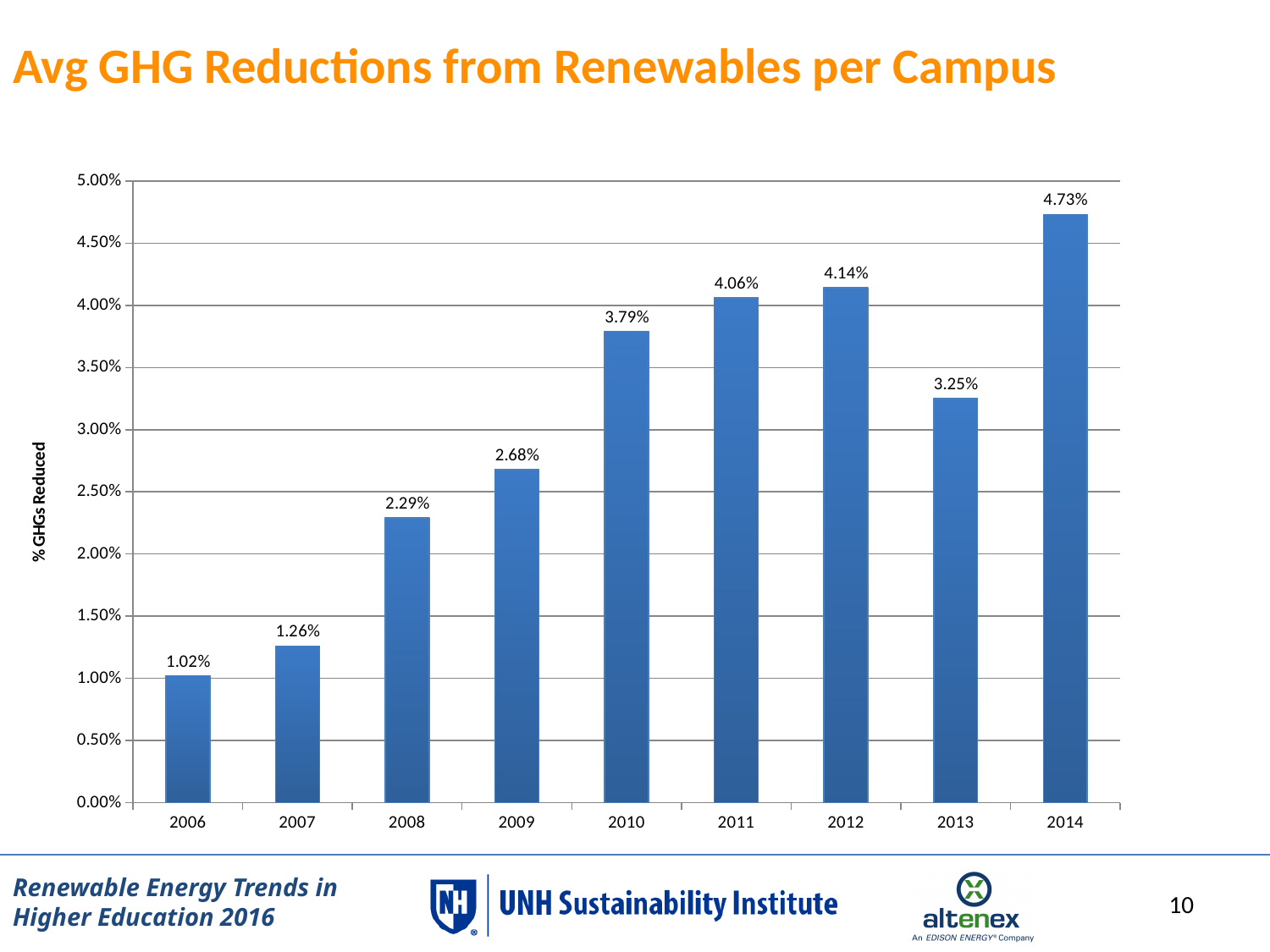
What is the value for 2010? 3.79% Which is larger, the value for 2011 or the value for 2012? 2012 What is the difference between the values for 2014 and 2013? 1.48% Which year has the highest value? 2014 Which year has the lowest value? 2006 What is the value for 2013? 3.25% What is the label of the y axis? % GHGs Reduced Is the value for 2009 greater or less than 3.00%? less What is the value for 2006? 1.02% What is the difference between the values for 2008 and 2007? 1.03% How many years are shown on the x axis? 9 What kind of chart is shown on the slide? bar chart